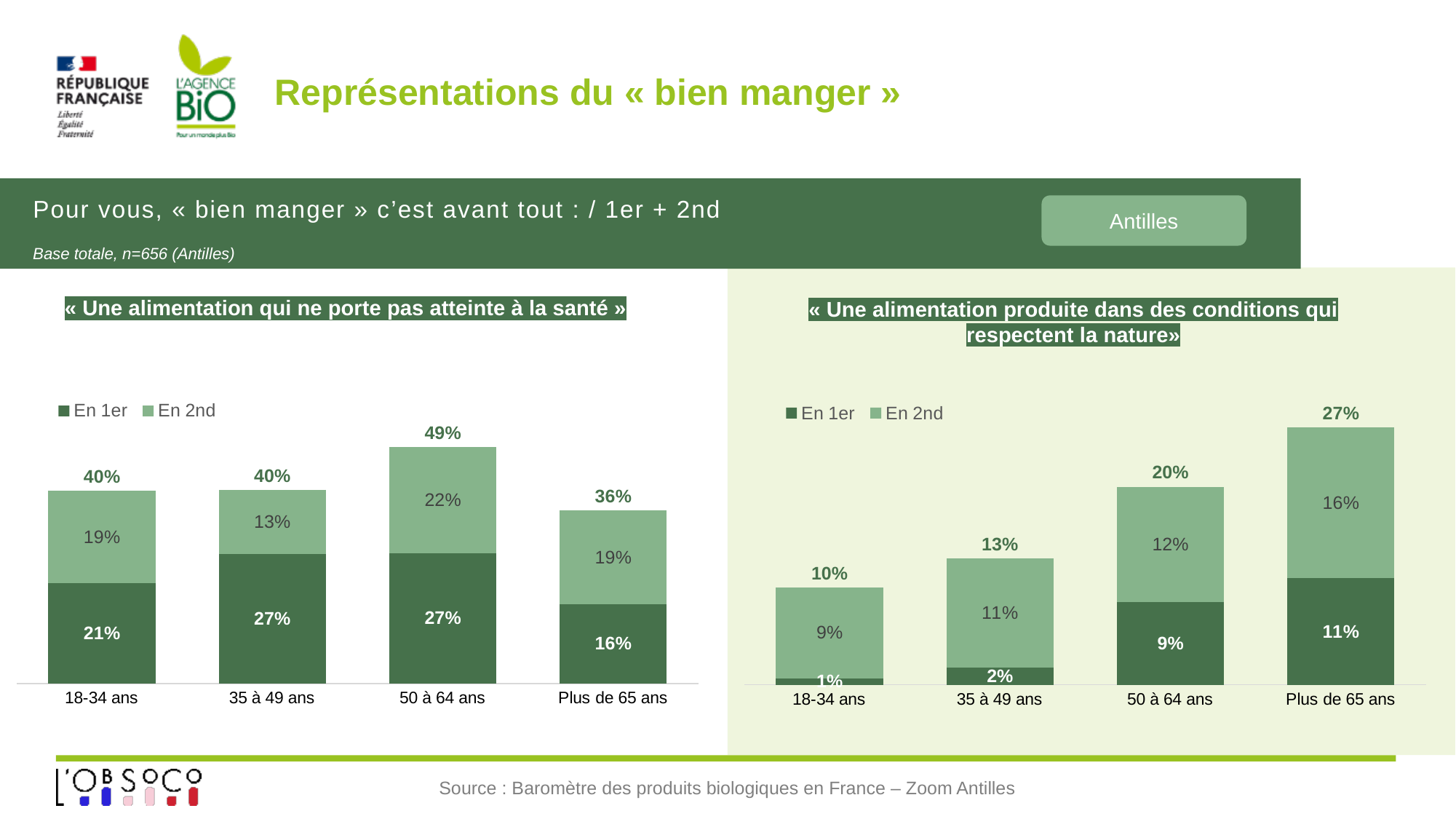
How many series does the legend of the left chart list? 2 In the left chart (« Une alimentation qui ne porte pas atteinte à la santé »), what is the 'En 2nd' value for 50 à 64 ans? 22% What kind of chart is the right chart (« Une alimentation produite dans des conditions qui respectent la nature »)? stacked bar chart In the right chart (« Une alimentation produite dans des conditions qui respectent la nature »), do the totals rise or fall as age increases from 18-34 ans to Plus de 65 ans? rise In the right chart (« Une alimentation produite dans des conditions qui respectent la nature »), which is larger: the 'En 2nd' value for 35 à 49 ans or for Plus de 65 ans? Plus de 65 ans In the right chart (« Une alimentation produite dans des conditions qui respectent la nature »), what is the total for Plus de 65 ans? 27% In the right chart (« Une alimentation produite dans des conditions qui respectent la nature »), what is the 'En 1er' value for 50 à 64 ans? 9% In the left chart (« Une alimentation qui ne porte pas atteinte à la santé »), what is the total for Plus de 65 ans? 36% In the right chart (« Une alimentation produite dans des conditions qui respectent la nature »), which age group has the lowest total? 18-34 ans In the left chart (« Une alimentation qui ne porte pas atteinte à la santé »), what is the 'En 1er' value for 18-34 ans? 21% In the left chart (« Une alimentation qui ne porte pas atteinte à la santé »), which age group has the highest total? 50 à 64 ans In the left chart (« Une alimentation qui ne porte pas atteinte à la santé »), what is the difference between the 'En 2nd' values for 50 à 64 ans and 35 à 49 ans? 9%